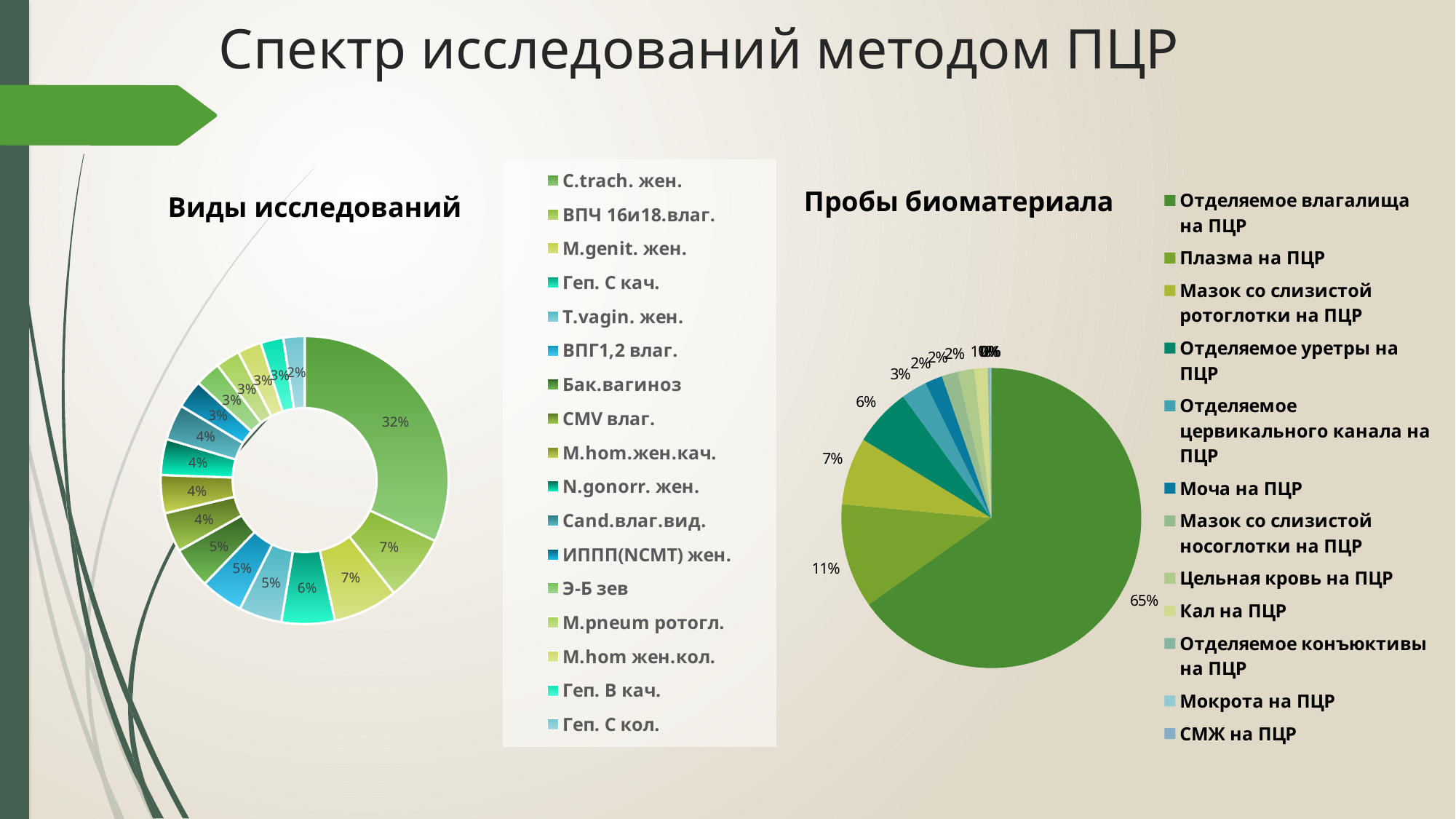
In the 'Виды исследований' chart, what share is shown for 'C.trach. жен.'? 32% In the 'Пробы биоматериала' chart, which is larger: 'Плазма на ПЦР' or 'Мазок со слизистой ротоглотки на ПЦР'? Плазма на ПЦР How many entries does the legend of the 'Пробы биоматериала' chart list? 12 What kind of chart is the 'Виды исследований' chart? Doughnut chart What kind of chart is the 'Пробы биоматериала' chart? Pie chart In the 'Пробы биоматериала' chart, what share is shown for 'Мазок со слизистой ротоглотки на ПЦР'? 7% In the 'Пробы биоматериала' chart, which category has the largest slice? Отделяемое влагалища на ПЦР In the 'Пробы биоматериала' chart, what is the difference in percentage points between 'Отделяемое влагалища на ПЦР' and 'Плазма на ПЦР'? 54 percentage points In the 'Пробы биоматериала' chart, what share is shown for 'Плазма на ПЦР'? 11% In the 'Виды исследований' chart, which category has the largest share? C.trach. жен.